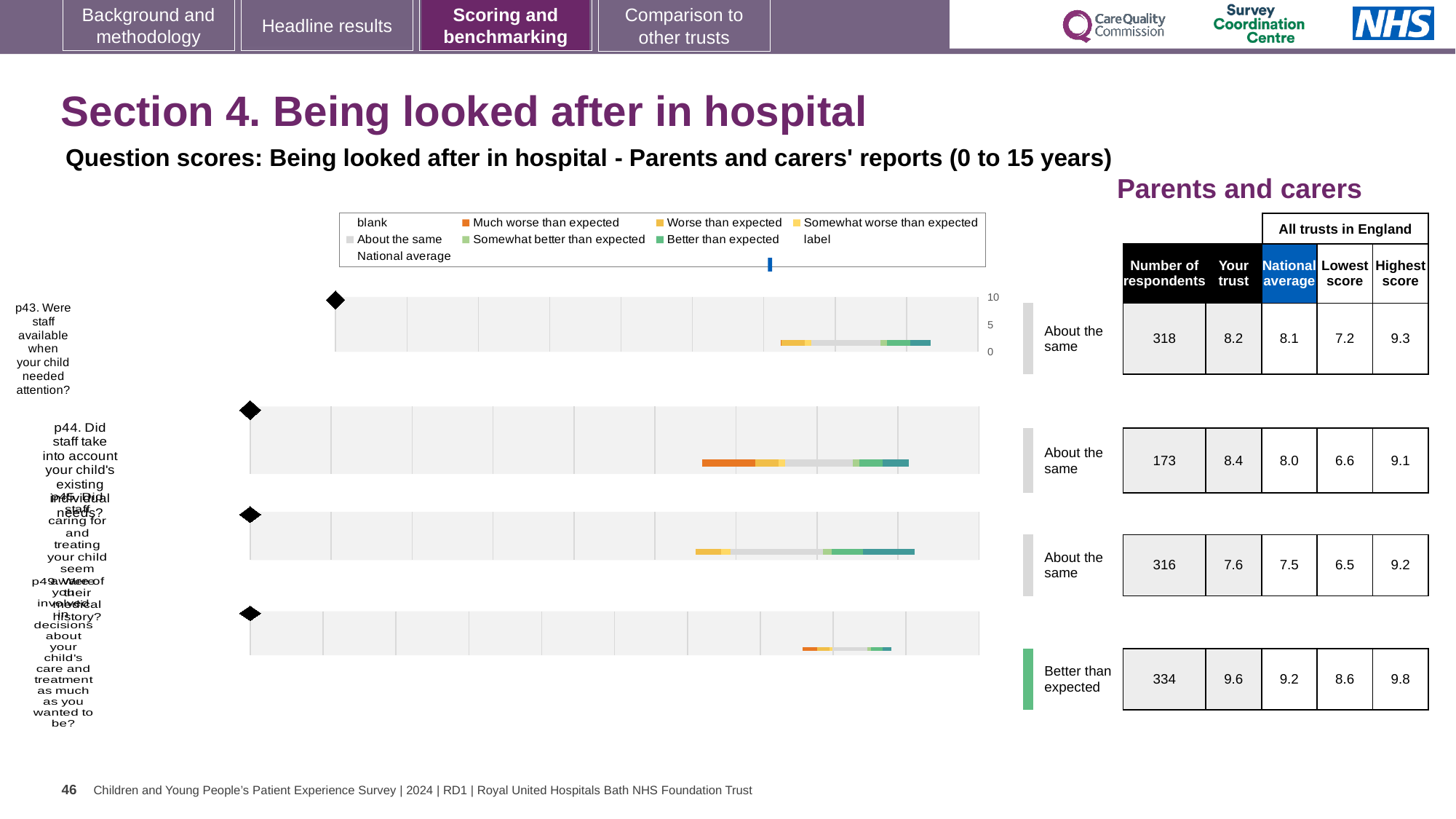
For the p43 chart (Were staff available when your child needed attention?), what is the number of respondents shown in the table? 318 For the p43 chart, which is larger: the 'Your trust' score or the national average? Your trust For the p43 chart, what is the 'Your trust' score? 8.2 What benchmark category is shown for the bottom question row on the slide? Better than expected Which question row on the slide has the highest 'Your trust' score? The bottom row (Better than expected), 9.6 Which question row on the slide has the lowest 'Your trust' score? The third row, 7.6 What kind of chart is used for the p43 question row on the slide? bar chart How many question rows (charts) are shown on the slide? 4 For the p43 chart, what is the national average score? 8.1 What is the number of respondents for the second question row (p44)? 173 For the p43 chart, what is the difference between the highest score and the lowest score across all trusts in England? 2.1 In the legend, what colour represents 'Much worse than expected'? Orange